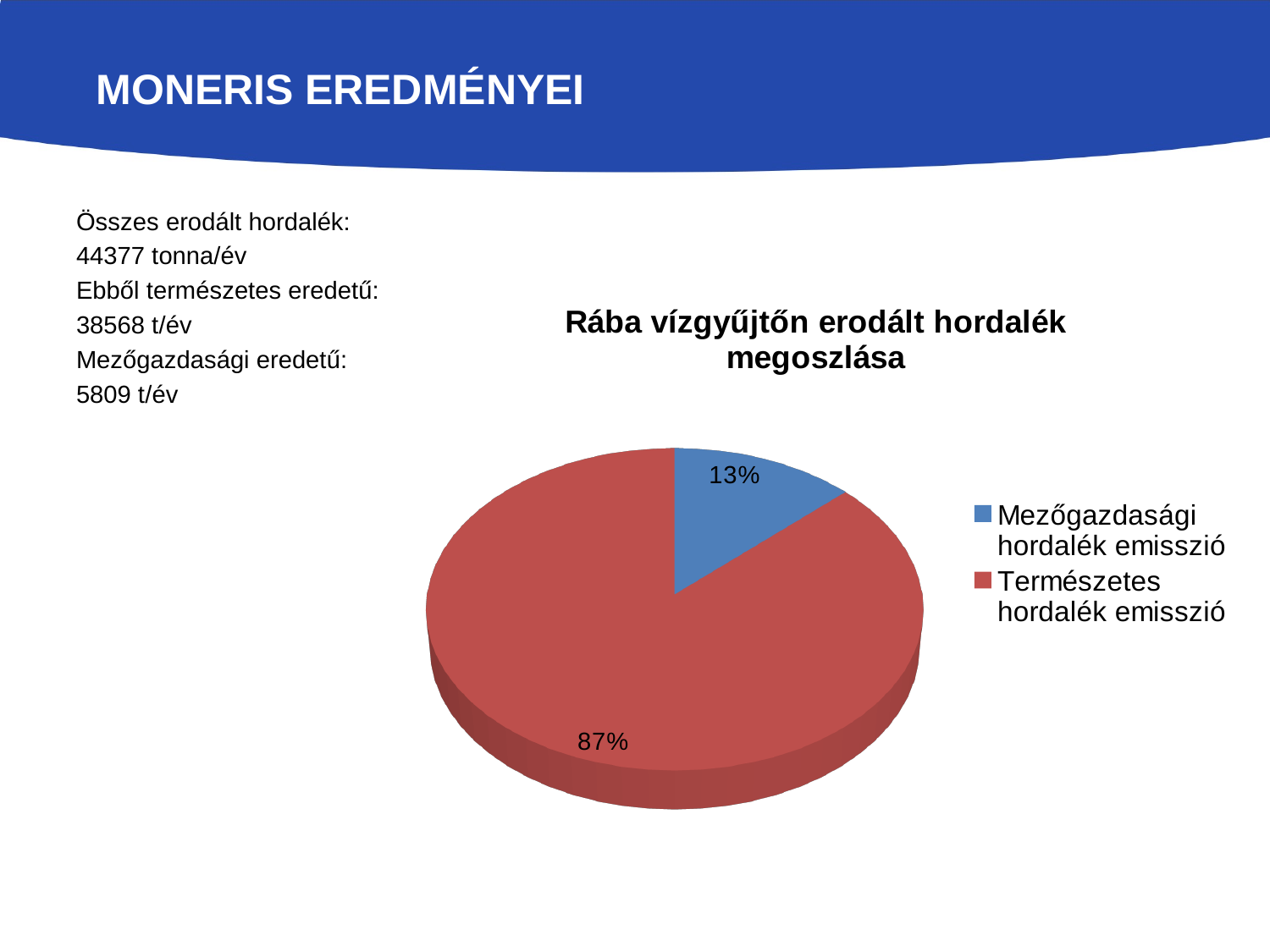
Which is larger, the Mezőgazdasági hordalék emisszió slice or the Természetes hordalék emisszió slice? Természetes hordalék emisszió What colour is the Természetes hordalék emisszió slice? Red What is the title of the chart? Rába vízgyűjtőn erodált hordalék megoszlása Which slice of the pie is the smallest? Mezőgazdasági hordalék emisszió What share of the pie does Mezőgazdasági hordalék emisszió represent? 13% How many slices does the pie chart have? 2 How many entries does the legend list? 2 What is the difference in percentage points between the Természetes hordalék emisszió slice and the Mezőgazdasági hordalék emisszió slice? 74 percentage points What share of the pie does Természetes hordalék emisszió represent? 87% What kind of chart is shown on the slide? Pie chart Which slice of the pie is the largest? Természetes hordalék emisszió